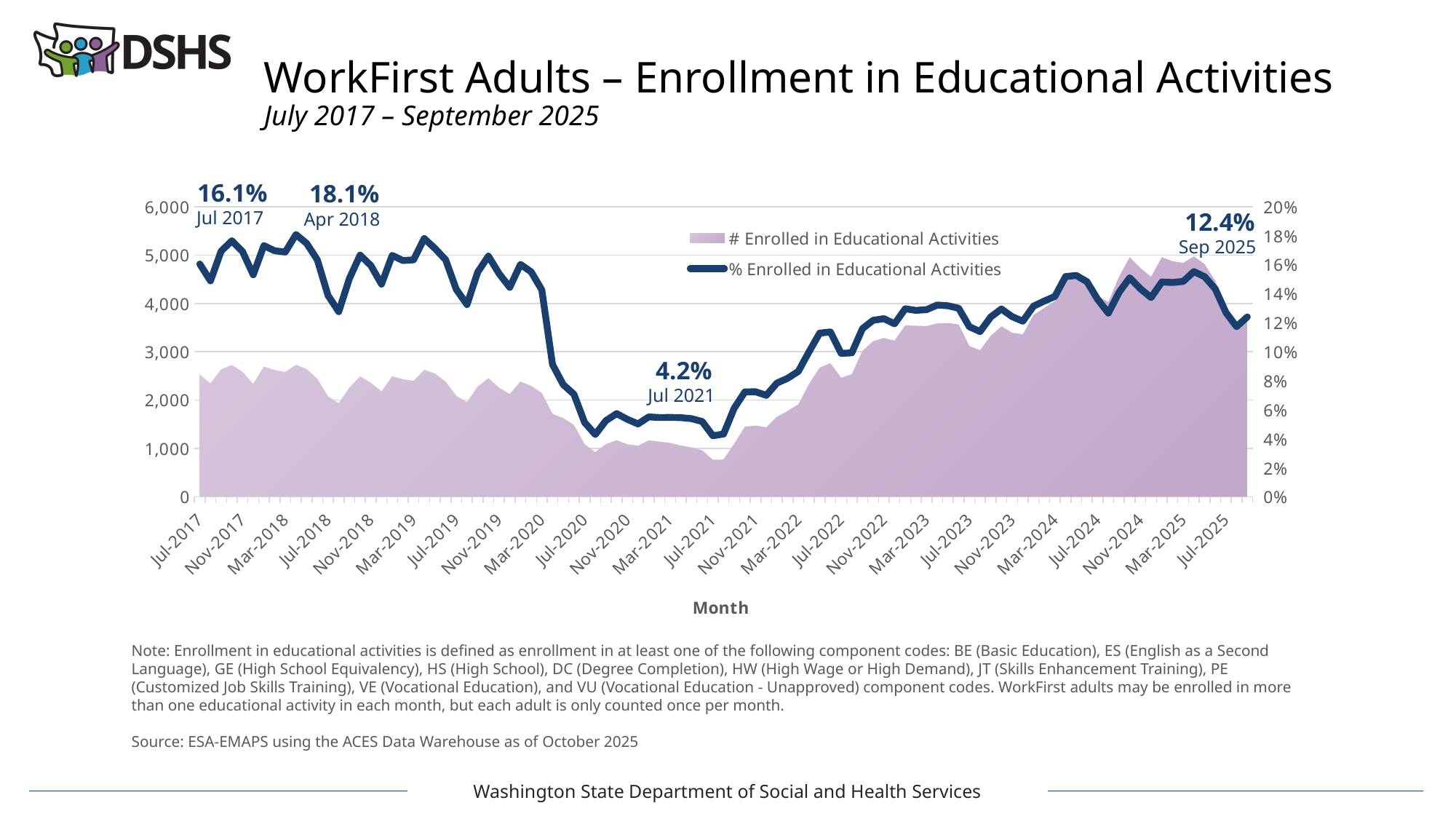
What is the % Enrolled in Educational Activities value labeled for Jul 2017? 16.1% What is the % Enrolled in Educational Activities value labeled for Apr 2018? 18.1% Does the % Enrolled in Educational Activities rise or fall between Apr 2018 and Jul 2021? fall Which labeled month has the lowest % Enrolled in Educational Activities? Jul 2021 Which labeled month has the highest % Enrolled in Educational Activities? Apr 2018 Which is larger, the % Enrolled in Educational Activities in Jul 2017 or in Sep 2025? Jul 2017 How many series does the legend list? 2 Is the # Enrolled in Educational Activities in Jul 2021 greater or less than 1,000? less What is the % Enrolled in Educational Activities value labeled for Jul 2021? 4.2% What is the % Enrolled in Educational Activities value labeled for Sep 2025? 12.4% What is the title of the x axis? Month What is the difference in percentage points between the labeled values for Apr 2018 and Jul 2021? 13.9 percentage points